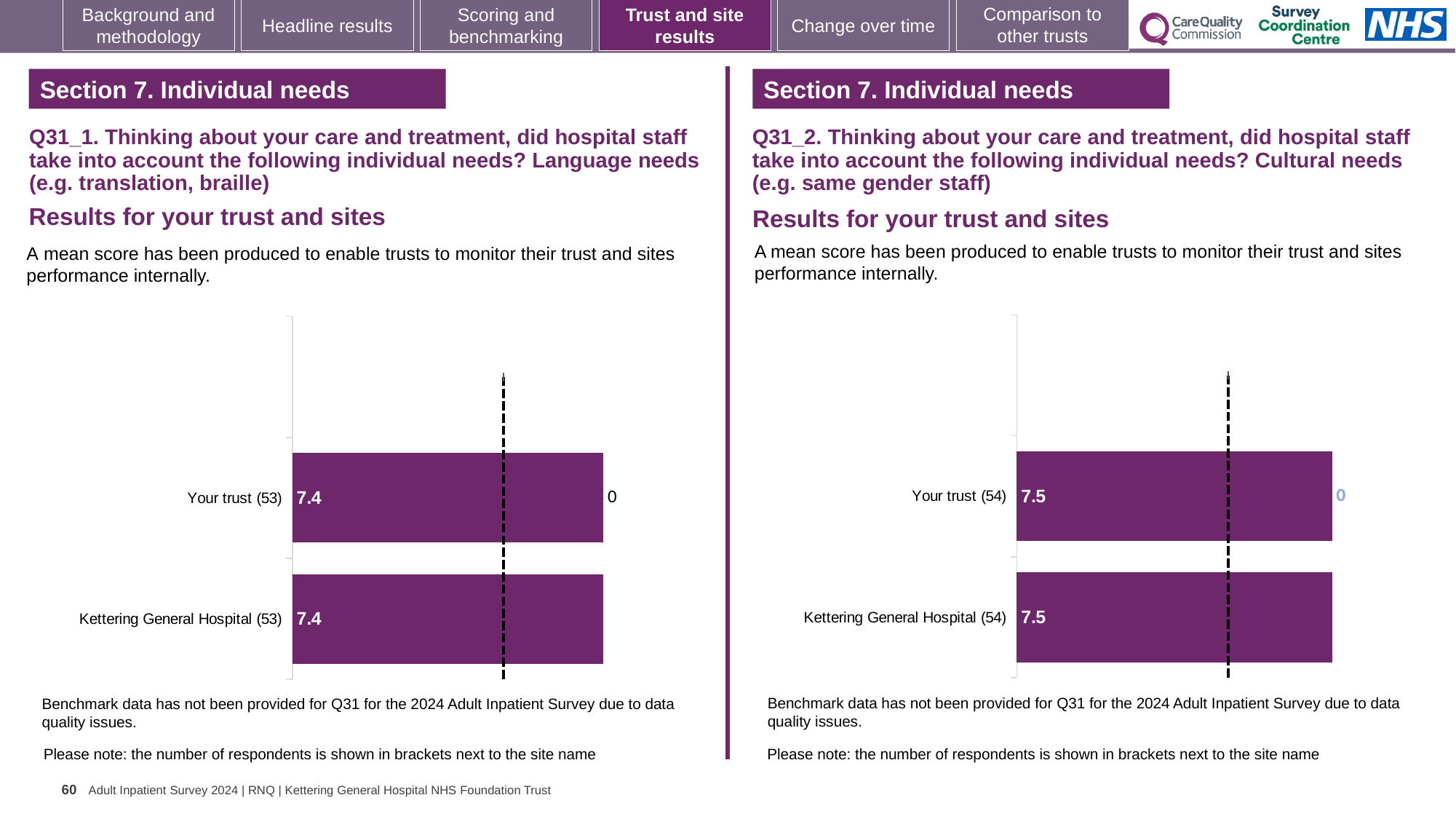
How many bars are plotted on the right chart (Q31_2, Cultural needs)? 2 On the left chart (Q31_1, Language needs), how many respondents are shown in brackets next to Your trust? 53 On the right chart (Q31_2, Cultural needs), what is the mean score for Kettering General Hospital? 7.5 On the left chart (Q31_1, Language needs), what is the mean score for Your trust? 7.4 On the right chart (Q31_2, Cultural needs), what is the mean score for Your trust? 7.5 How many bars are plotted on the left chart (Q31_1, Language needs)? 2 On the right chart (Q31_2, Cultural needs), how many respondents are shown in brackets next to Kettering General Hospital? 54 On the left chart (Q31_1, Language needs), what is the mean score for Kettering General Hospital? 7.4 On the left chart (Q31_1, Language needs), what is the difference between the scores for Your trust and Kettering General Hospital? 0 On the right chart (Q31_2, Cultural needs), what is the difference between the scores for Your trust and Kettering General Hospital? 0 What type of chart is used on the left (Q31_1, Language needs)? Bar chart Which is larger: the Your trust score on the left chart (Q31_1) or the Your trust score on the right chart (Q31_2)? Right chart (Q31_2), 7.5